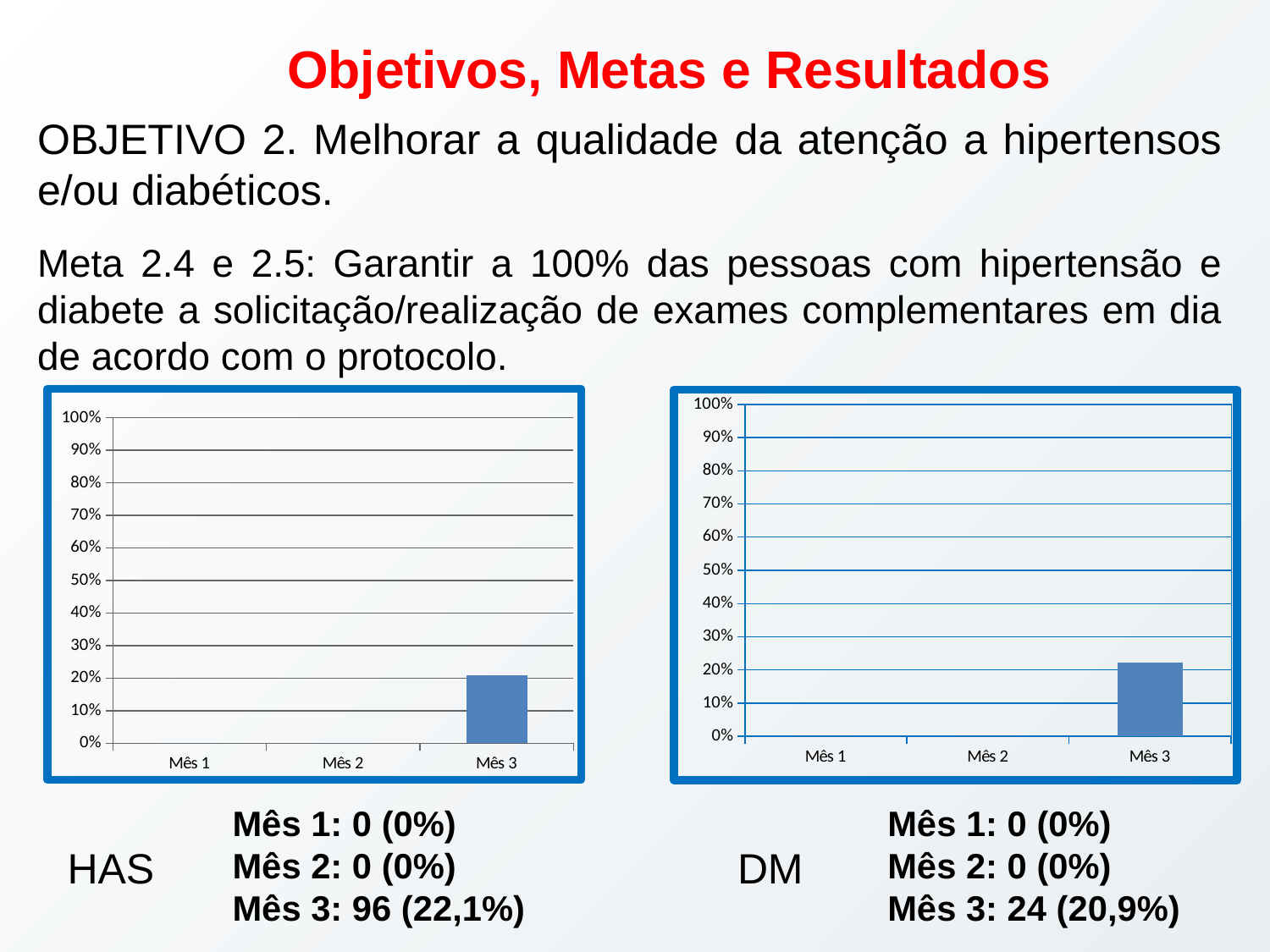
What is the highest value shown on the y axis of the left chart (HAS)? 100% In the right chart (DM), which month has the highest value? Mês 3 How many categories are shown on the x axis of the right chart (DM)? 3 How many categories are shown on the x axis of the left chart (HAS)? 3 In the left chart (HAS), is the value for Mês 3 greater or less than 10%? greater According to the text below the left chart, what percentage is shown for HAS in Mês 3? 22,1% In the left chart (HAS), which month has the highest value? Mês 3 What kind of chart is the left chart (HAS)? bar chart In the right chart (DM), is the value for Mês 3 greater or less than 30%? less According to the text below the right chart, what percentage is shown for DM in Mês 3? 20,9% In the left chart (HAS), is the value for Mês 3 greater or less than 30%? less